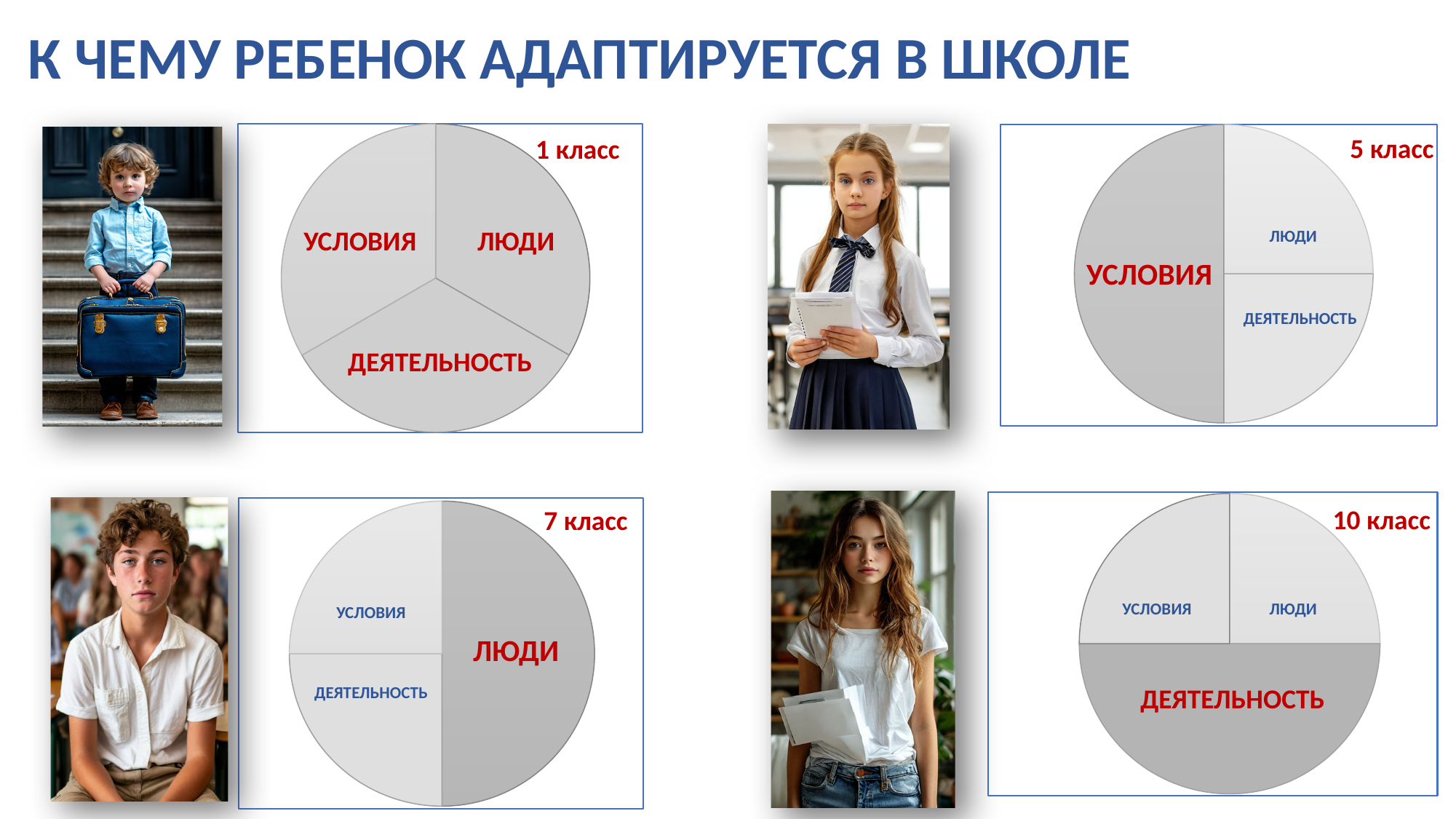
What are the three categories shown in the 1 класс pie chart? УСЛОВИЯ, ЛЮДИ, ДЕЯТЕЛЬНОСТЬ How many slices does the 5 класс pie chart have? 3 In the 7 класс pie chart, which category has the largest slice? ЛЮДИ In the 10 класс pie chart, which category has the largest slice? ДЕЯТЕЛЬНОСТЬ In the 5 класс pie chart, which category has the largest slice? УСЛОВИЯ How many pie charts are on the slide? 4 What is the title of the slide? К ЧЕМУ РЕБЕНОК АДАПТИРУЕТСЯ В ШКОЛЕ In the 10 класс pie chart, which slice is larger: ДЕЯТЕЛЬНОСТЬ or ЛЮДИ? ДЕЯТЕЛЬНОСТЬ What kind of chart is shown for 1 класс? pie chart In the 5 класс pie chart, which slice is larger: УСЛОВИЯ or ДЕЯТЕЛЬНОСТЬ? УСЛОВИЯ In the 7 класс pie chart, which slice is larger: ЛЮДИ or УСЛОВИЯ? ЛЮДИ